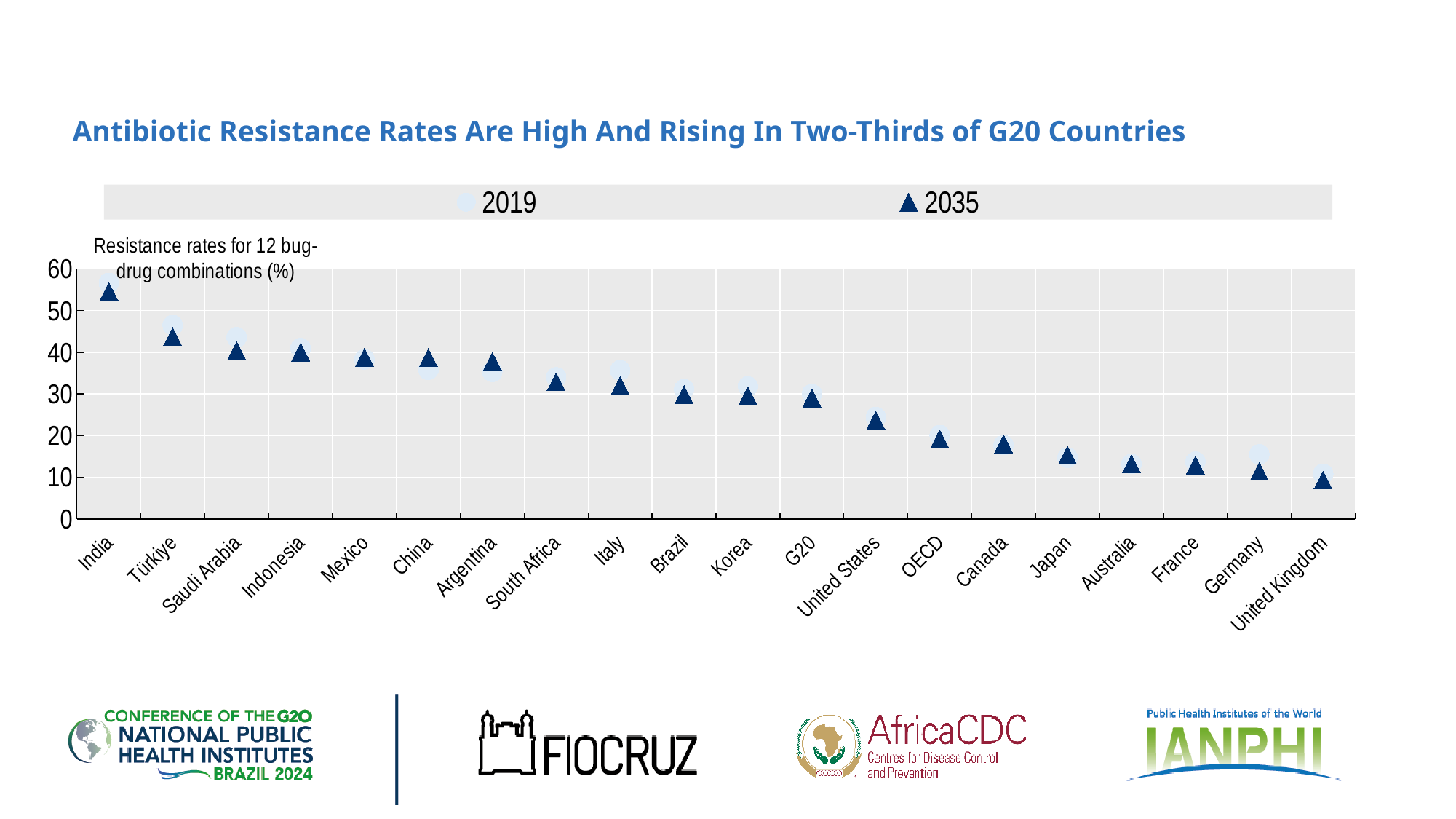
What kind of chart is shown on the slide? Scatter (dot) chart Which country has the highest 2035 resistance rate? India How many countries or groups are plotted along the x axis? 20 Is the 2035 value for the United States greater or less than 30? less Do the 2035 values rise or fall moving from left to right along the x axis? Fall Is the 2035 value for Türkiye greater or less than 40? greater Which country has the lowest 2035 resistance rate? United Kingdom Is the 2035 value for India greater or less than 50? greater Which two series are listed in the legend? 2019 and 2035 Which has a higher 2035 resistance rate, India or Germany? India How many series does the legend list? 2